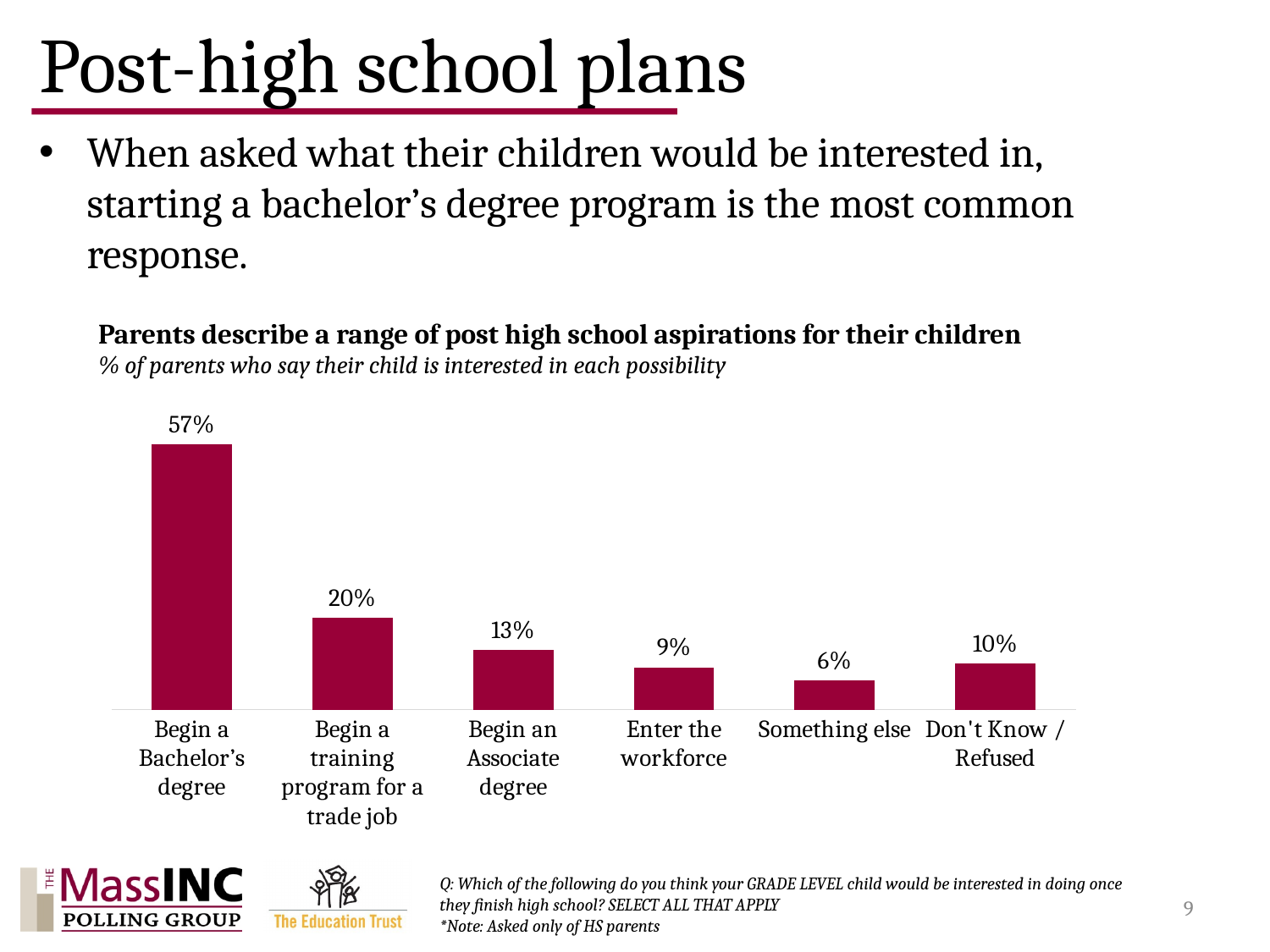
Which category has the lowest value? Something else How many categories are shown in the chart? 6 What percentage of parents say their child is interested in entering the workforce? 9% What is the value for 'Don't Know / Refused'? 10% What percentage of parents say their child is interested in beginning a Bachelor's degree? 57% What is the difference between 'Begin an Associate degree' and 'Enter the workforce'? 4% Which is larger: the value for 'Don't Know / Refused' or the value for 'Enter the workforce'? Don't Know / Refused Which category has the highest value? Begin a Bachelor's degree What is the value for 'Begin a training program for a trade job'? 20% What is the difference between the values for 'Begin a Bachelor's degree' and 'Begin a training program for a trade job'? 37% What is the title of the chart? Parents describe a range of post high school aspirations for their children What type of chart is shown on the slide? Bar chart